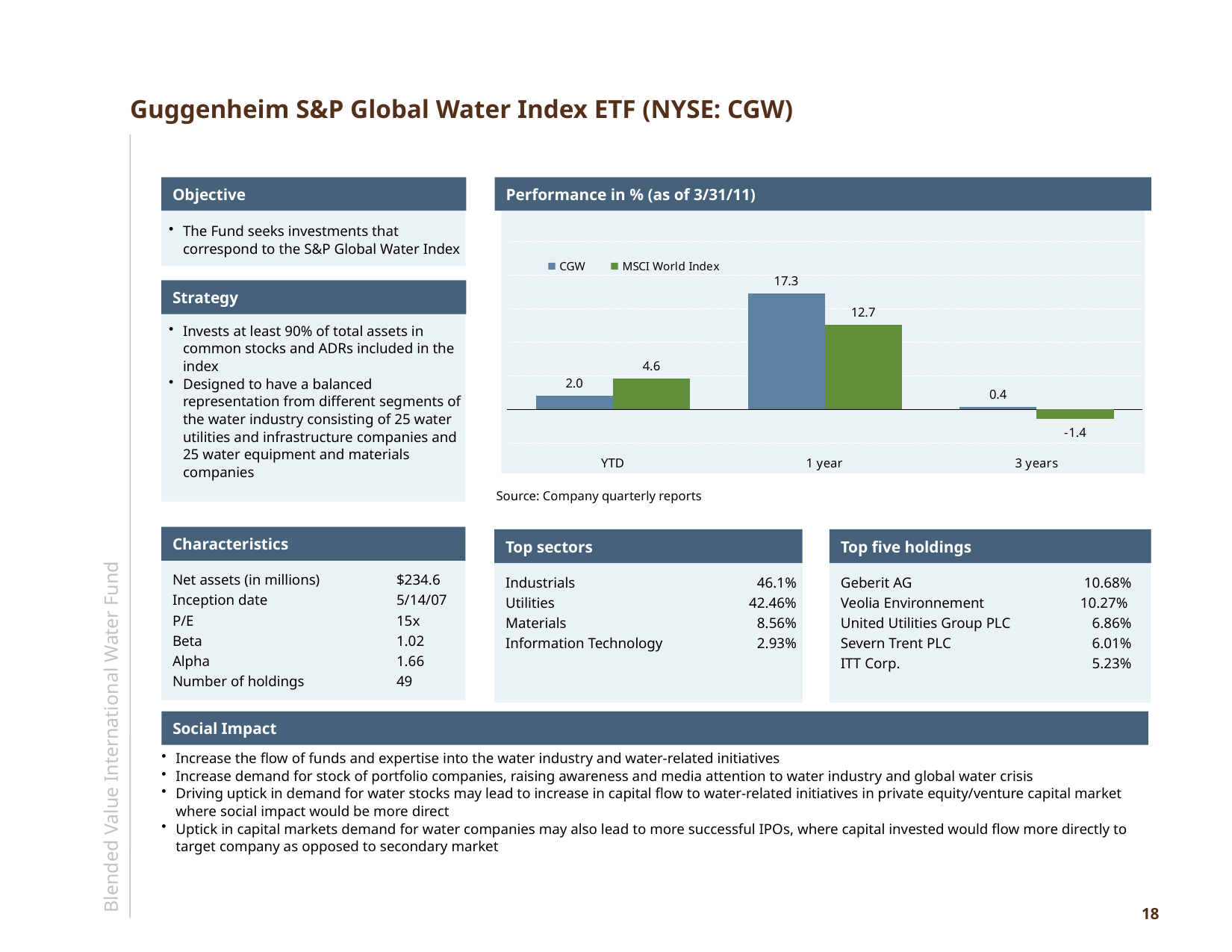
What is the title of the chart? Performance in % (as of 3/31/11) Which period has the highest CGW value? 1 year Which period has the lowest MSCI World Index value? 3 years How many series does the legend of the performance chart list? 2 For YTD, which series has the larger value, CGW or MSCI World Index? MSCI World Index What is the difference between the CGW and MSCI World Index values for the 1 year period? 4.6 How many periods are shown on the x axis of the performance chart? 3 What is the MSCI World Index value for 3 years? -1.4 What is the CGW value for the 1 year period? 17.3 What is the MSCI World Index value for YTD? 4.6 What kind of chart is used to show performance? Bar chart What is the CGW value for YTD? 2.0